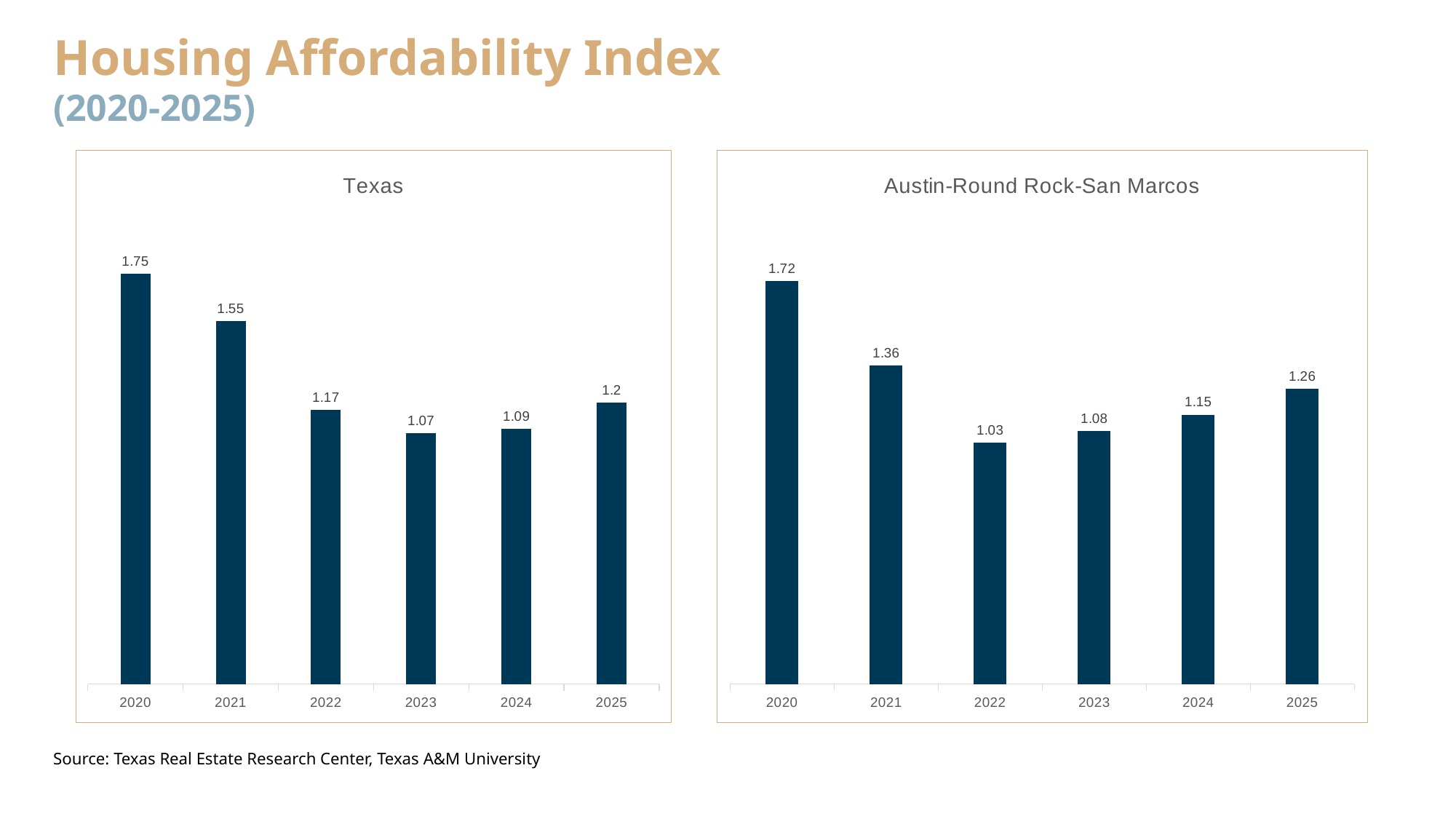
In the Austin-Round Rock-San Marcos chart, which is larger, the value for 2023 or the value for 2024? 2024 What kind of chart is the Austin-Round Rock-San Marcos chart? bar chart In the Texas chart, what is the difference between the 2020 and 2021 values? 0.2 How many years are shown in the Texas chart? 6 In the Texas chart, which year has the lowest value? 2023 In the Austin-Round Rock-San Marcos chart, what is the value for 2025? 1.26 In the Austin-Round Rock-San Marcos chart, which year has the highest value? 2020 In the Austin-Round Rock-San Marcos chart, what is the difference between the 2021 and 2022 values? 0.33 In the Texas chart, which is larger, the value for 2022 or the value for 2025? 2025 In the Texas chart, what is the value for 2020? 1.75 In the Texas chart, do the values rise or fall from 2020 to 2023? fall What is the title of the slide? Housing Affordability Index (2020-2025)